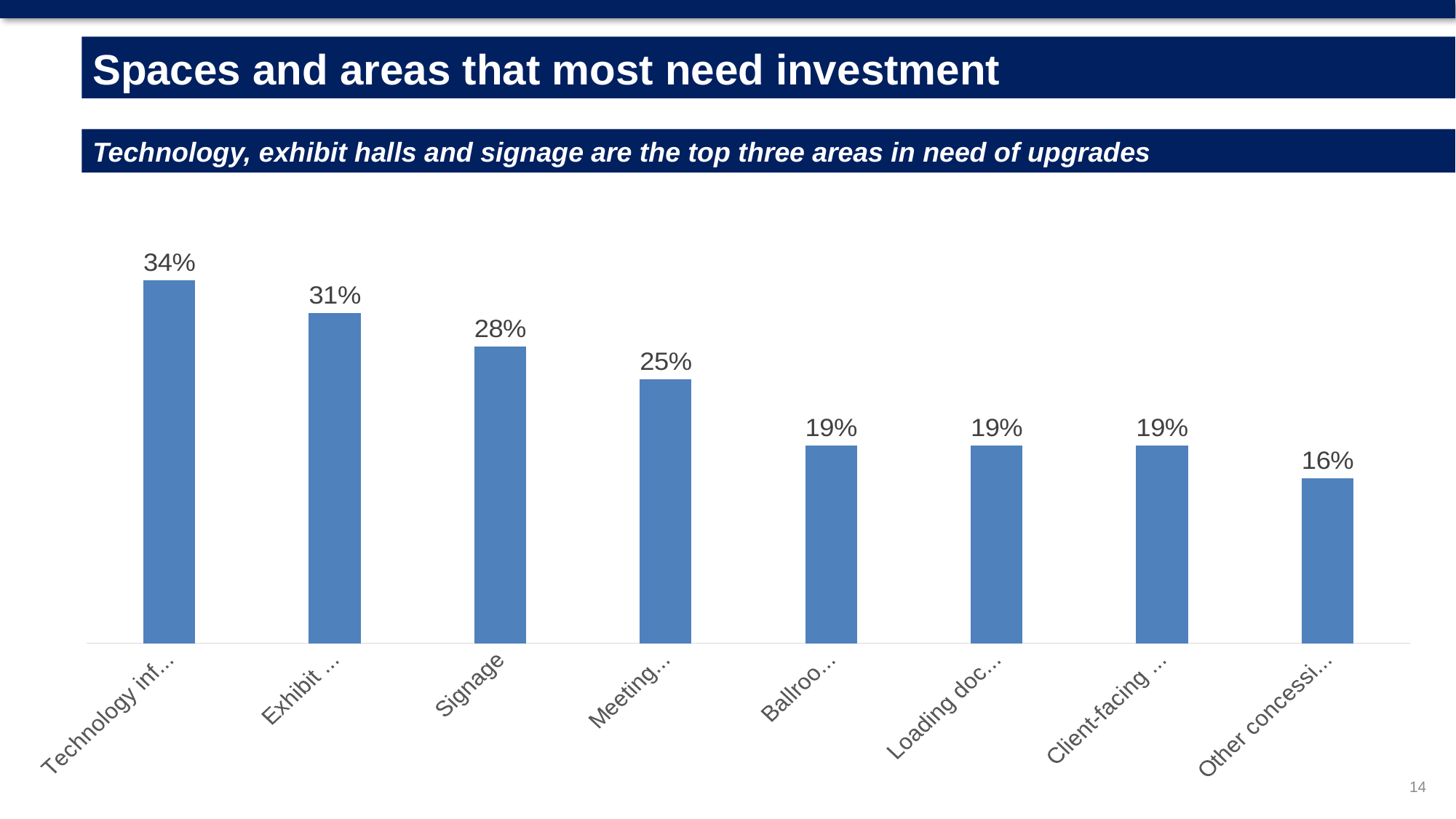
Which category has the lowest value? Other concessi… (last bar) Which category has the highest value? Technology inf… (first bar) What is the value for Signage? 28% Which is larger, the value for Signage or the value for the second bar (Exhibit …)? Exhibit … (31%) What is the value of the last bar, labelled Other concessi…? 16% How many bars (categories) does the chart show? 8 What is the value of the first bar, labelled Technology inf…? 34% What type of chart is shown on the slide? bar chart Do the values rise or fall from left to right across the chart? fall What is the difference between the first bar (Technology inf…) and Signage? 6% What is the value of the fourth bar, labelled Meeting…? 25% How many bars share the value 19%? 3